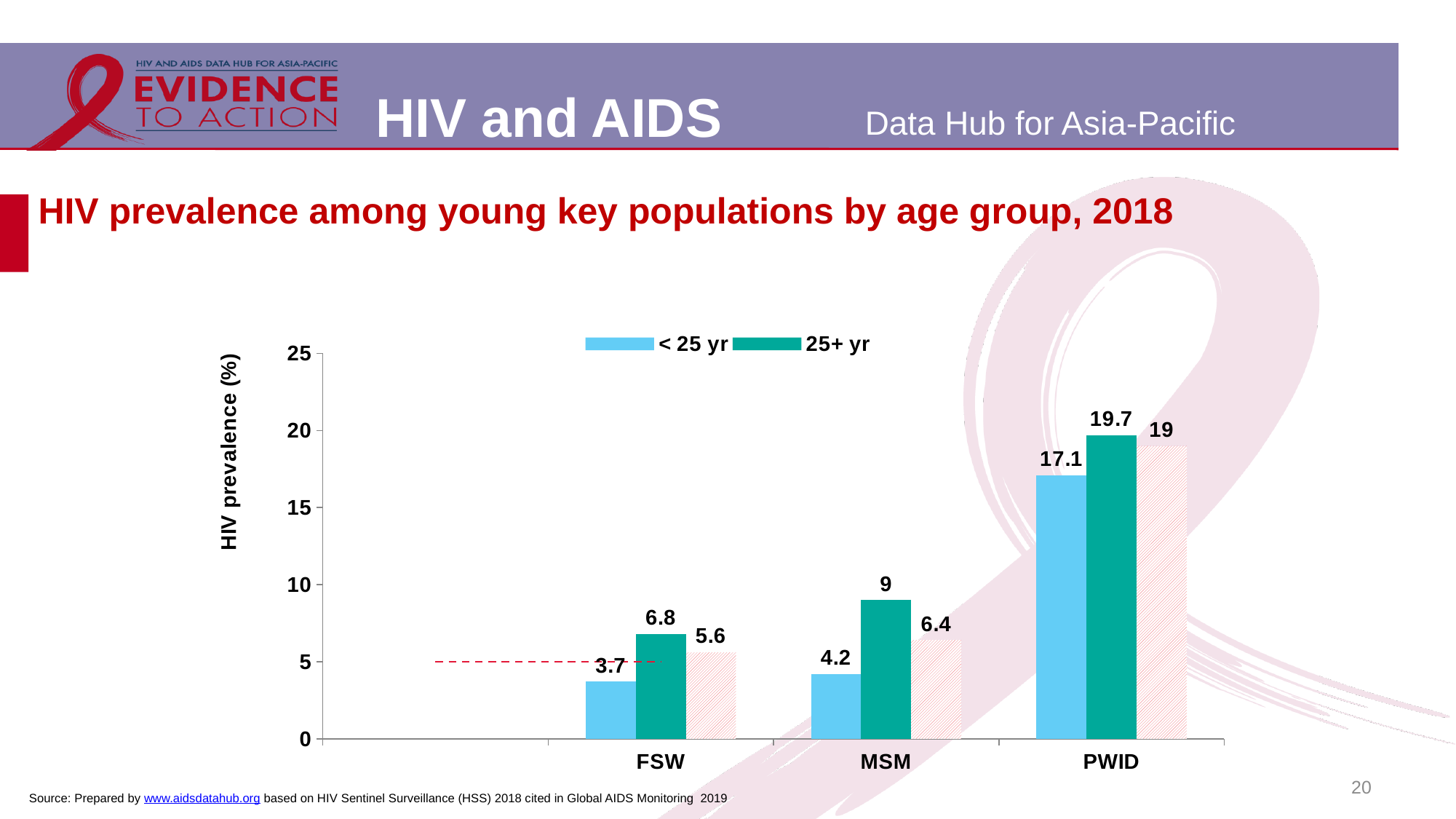
What is the difference between the 25+ yr and < 25 yr HIV prevalence for FSW? 3.1 What is the HIV prevalence for FSW aged under 25 years? 3.7 What is the HIV prevalence for PWID aged 25+ years? 19.7 What is the HIV prevalence for MSM aged 25+ years? 9 Which key population has the highest HIV prevalence in the 25+ yr series? PWID What is the HIV prevalence for PWID aged under 25 years? 17.1 How many key population categories are shown on the x axis? 3 What type of chart is shown on the slide? Bar chart Which key population has the lowest HIV prevalence in the < 25 yr series? FSW What is the difference between the 25+ yr and < 25 yr HIV prevalence for MSM? 4.8 How many series does the legend list? 2 Which is larger for MSM: the < 25 yr value or the 25+ yr value? 25+ yr